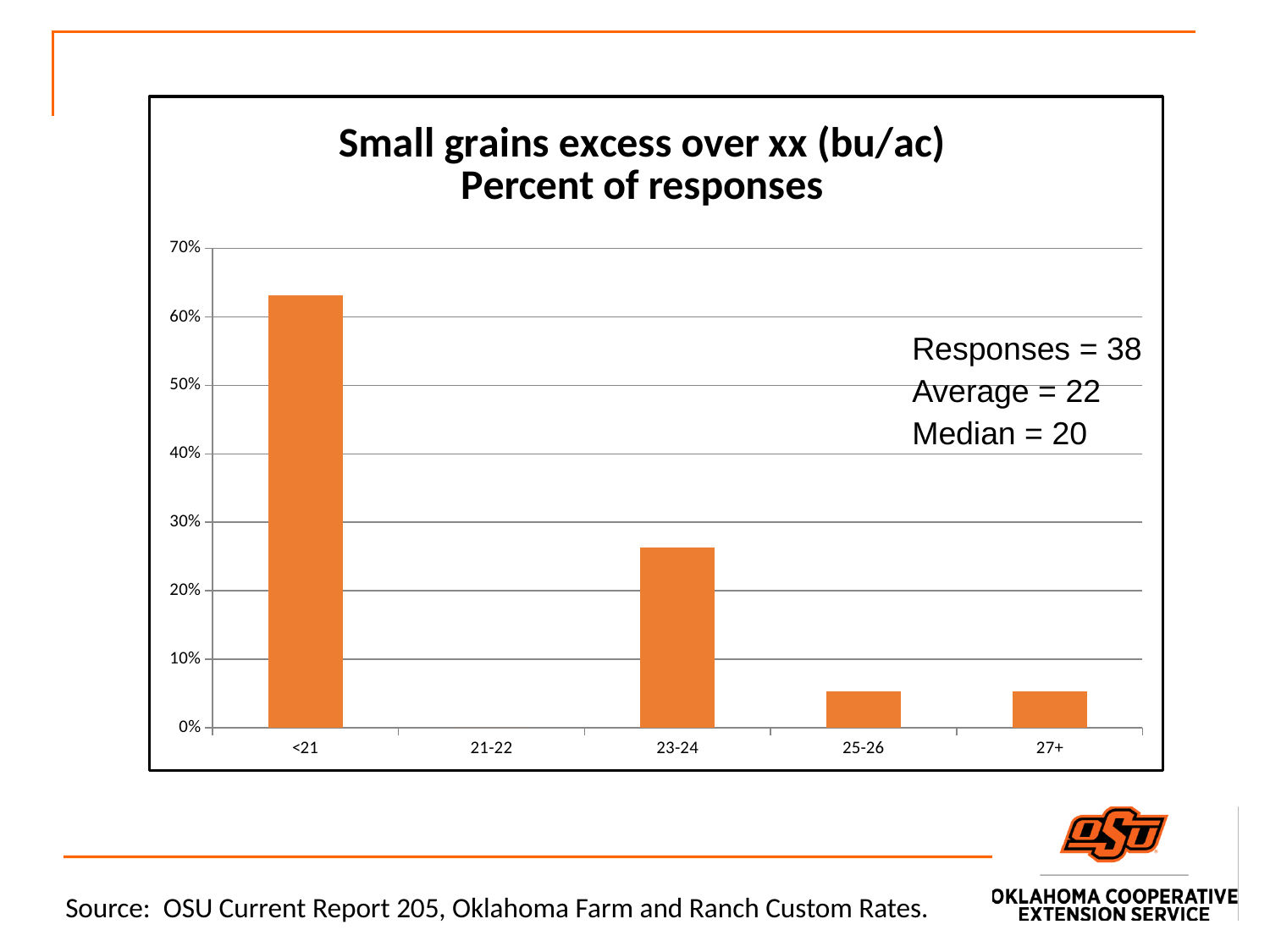
Is the value for 23-24 greater or less than 20%? greater According to the text on the chart, how many responses were there? 38 How many categories are shown on the x axis of the chart? 5 Is the value for 23-24 greater or less than 30%? less Which category has a larger percent of responses, <21 or 23-24? <21 What is the title of the chart? Small grains excess over xx (bu/ac) Percent of responses Is the value for <21 greater or less than 60%? greater Which category has the lowest percent of responses? 21-22 What kind of chart is shown on the slide? bar chart Which category has the highest percent of responses? <21